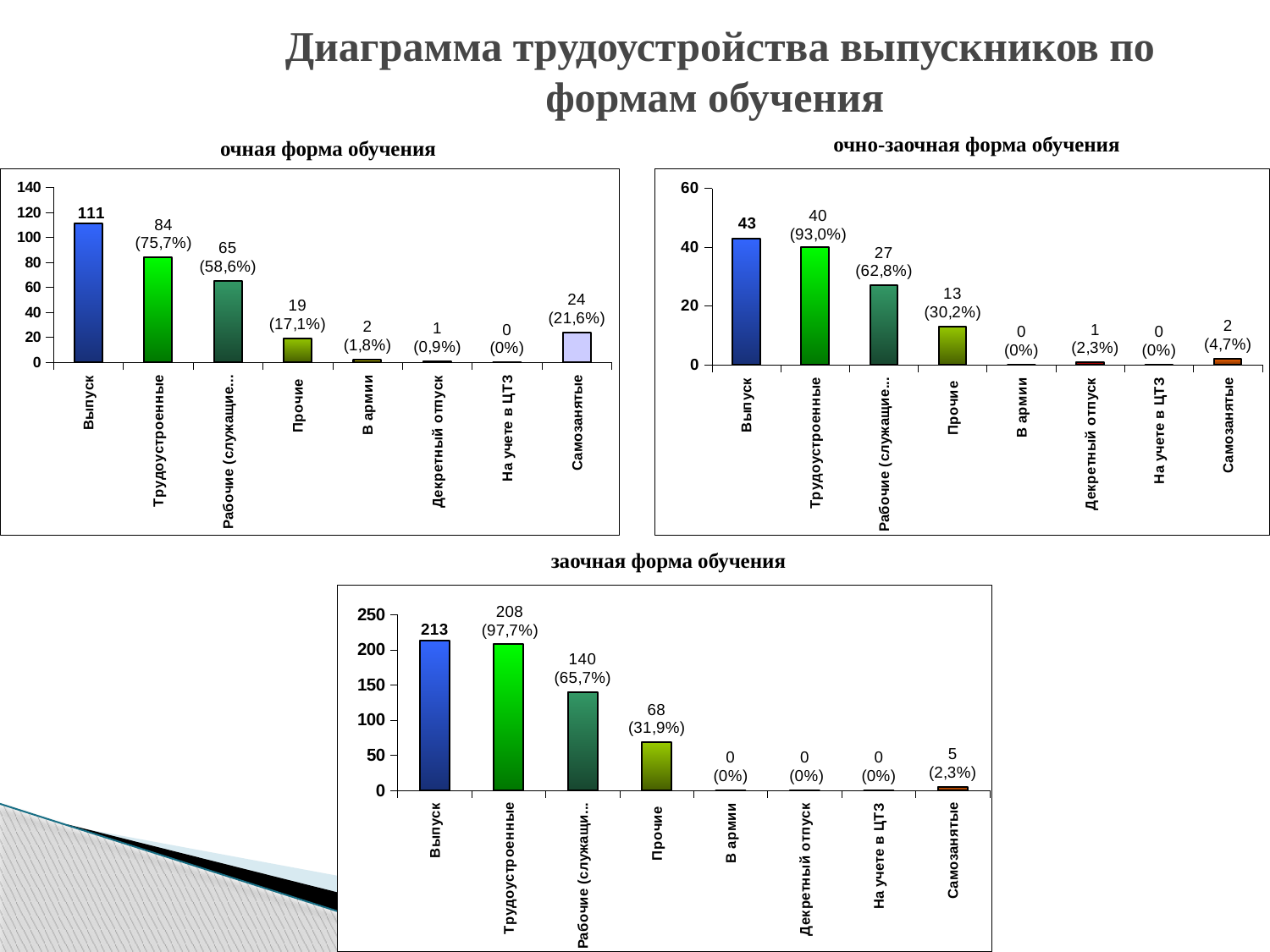
In the chart titled 'заочная форма обучения', what is the value for Трудоустроенные? 208 In the chart titled 'очно-заочная форма обучения', what percentage is shown for Рабочие (служащие...)? 62,8% In the chart titled 'очная форма обучения', what percentage is shown for Трудоустроенные? 75,7% In the chart titled 'заочная форма обучения', what is the difference between Выпуск and Рабочие (служащи...)? 73 In the chart titled 'заочная форма обучения', which is larger: Прочие or Самозанятые? Прочие In the chart titled 'очно-заочная форма обучения', which category has the highest value? Выпуск In the chart titled 'очная форма обучения', what is the value for Самозанятые? 24 In the chart titled 'очная форма обучения', what is the value for Выпуск? 111 How many categories are shown on the x axis of the chart titled 'заочная форма обучения'? 8 What type of chart is the chart titled 'очная форма обучения'? Bar chart In the chart titled 'очная форма обучения', what is the difference between Выпуск and Трудоустроенные? 27 In the chart titled 'очно-заочная форма обучения', what is the value for Прочие? 13